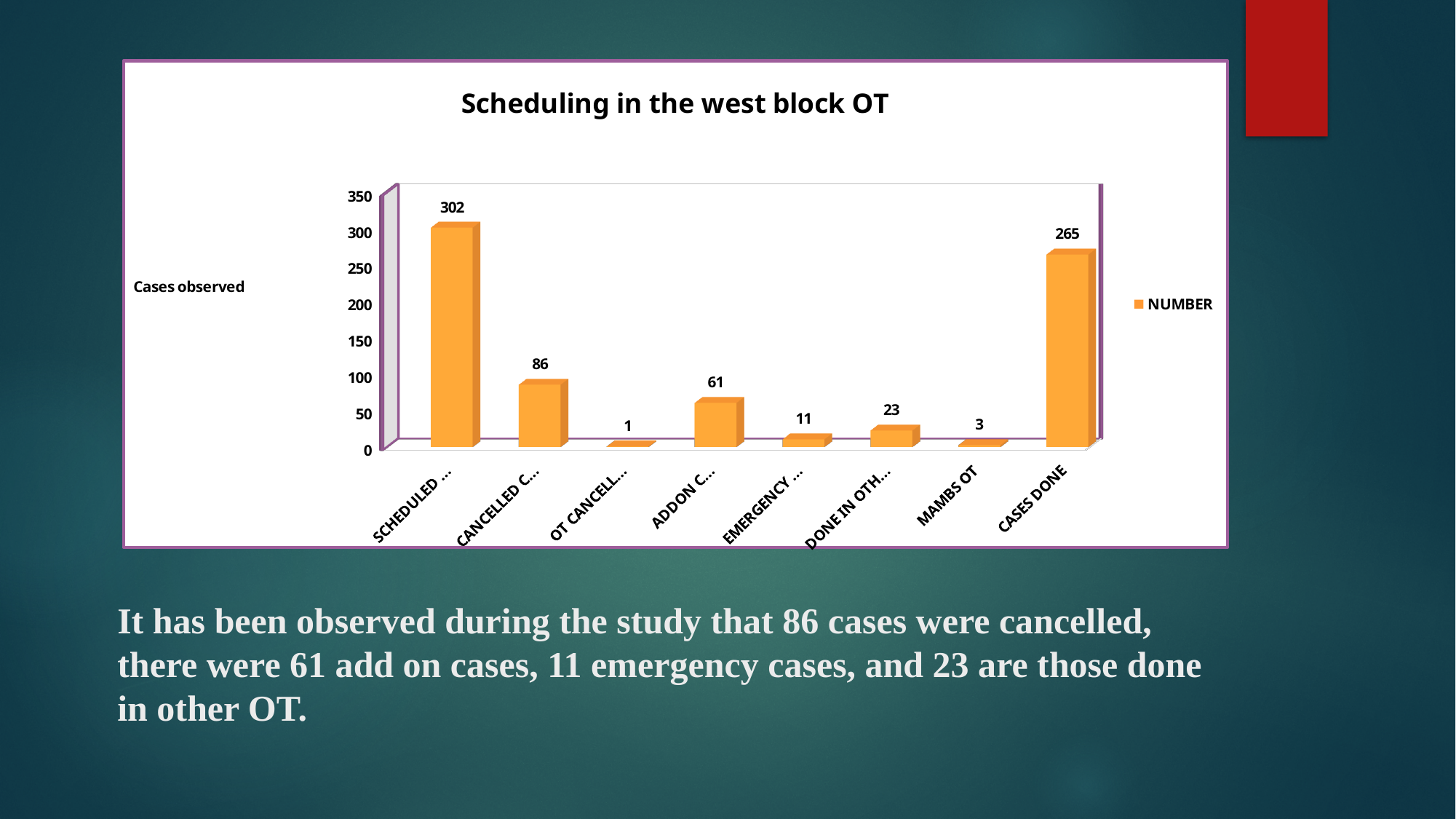
What is the lowest value shown on the chart? 1 What is the name of the series shown in the legend? NUMBER What is the title of the chart? Scheduling in the west block OT What is the highest value shown on the chart? 302 How many series does the legend list? 1 What is the value for MAMBS OT? 3 What is the value for CASES DONE? 265 Which is larger, the value for CASES DONE or the value for MAMBS OT? CASES DONE What type of chart is shown on the slide? bar chart What is the difference between the first bar (302) and the CASES DONE bar (265)? 37 Is the value for CASES DONE greater or less than 250? greater How many categories are plotted on the x axis? 8